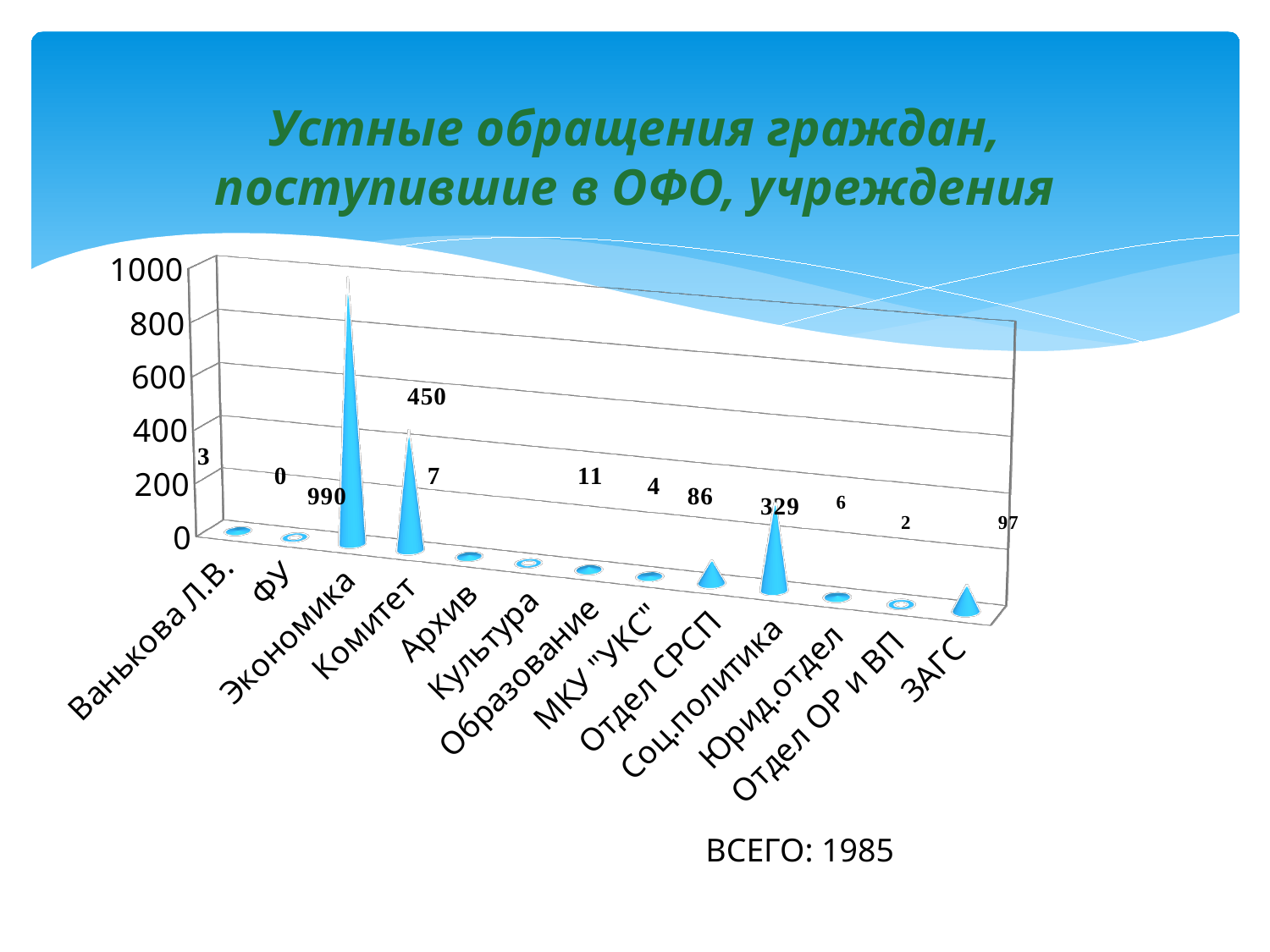
Is the value for Экономика greater or less than 800? greater What is the value for ЗАГС? 97 What is the value for Экономика? 990 What is the value for ФУ? 0 What is the difference between the values for Экономика and Комитет? 540 What total (ВСЕГО) is stated below the chart? 1985 Which category has the highest value? Экономика How many categories are shown on the x axis? 13 Which category has the lowest value? ФУ and Культура (both 0) Which is larger, the value for Соц.политика or the value for ЗАГС? Соц.политика What is the value for Комитет? 450 What is the value for Соц.политика? 329